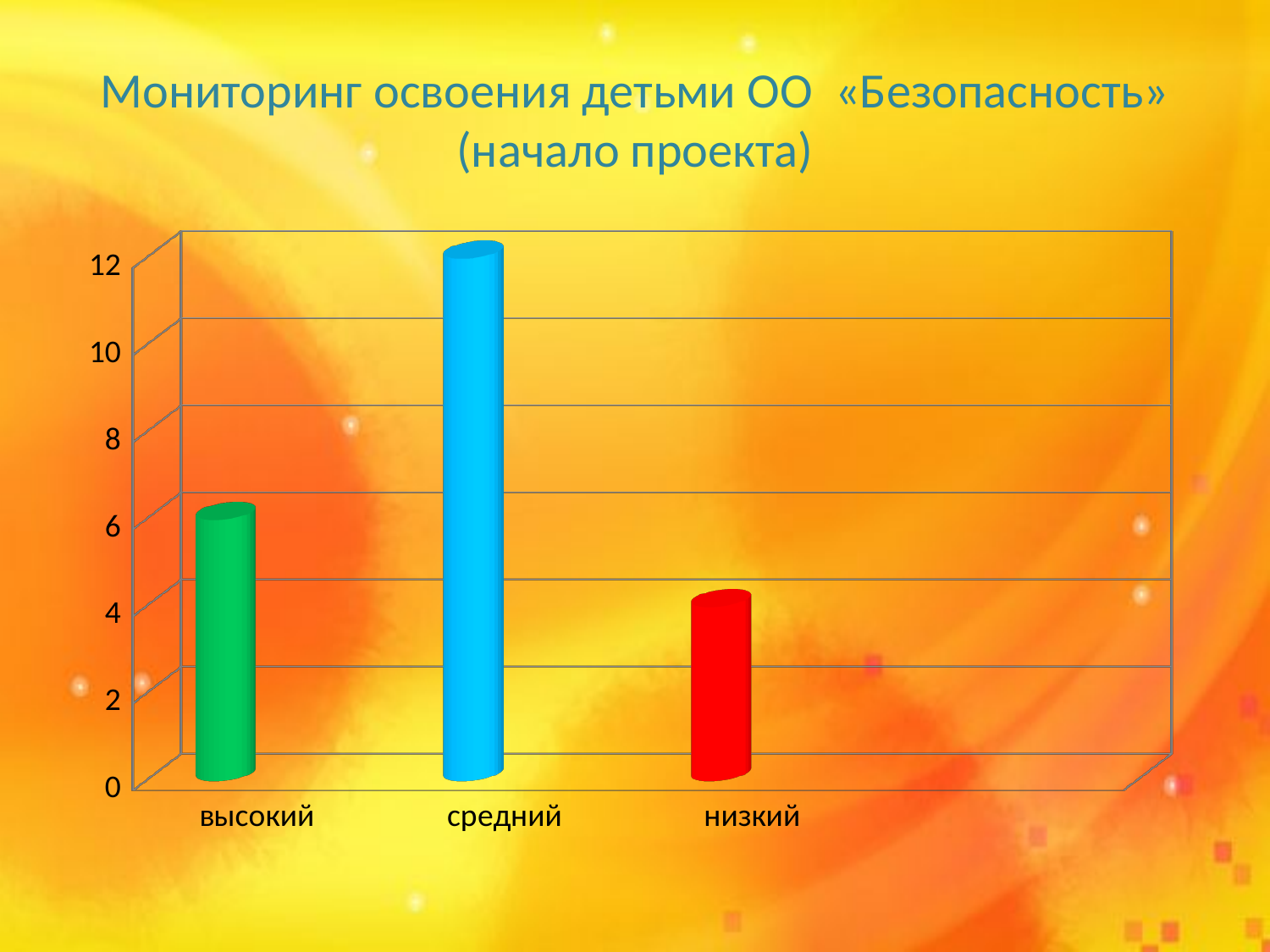
How many categories are shown on the x axis of the chart? 3 What is the title of the chart on the slide? Мониторинг освоения детьми ОО «Безопасность» (начало проекта) What is the value for средний in the chart? 12 Is the value for низкий greater or less than 2? greater Which is larger, the value for высокий or the value for низкий? высокий Which category has the lowest bar in the chart? низкий What type of chart is shown on the slide? bar chart Is the value for высокий greater or less than 8? less What is the value for низкий in the chart? 4 Which category has the highest bar in the chart? средний What is the value for высокий in the chart? 6 Is the value for средний greater or less than 10? greater